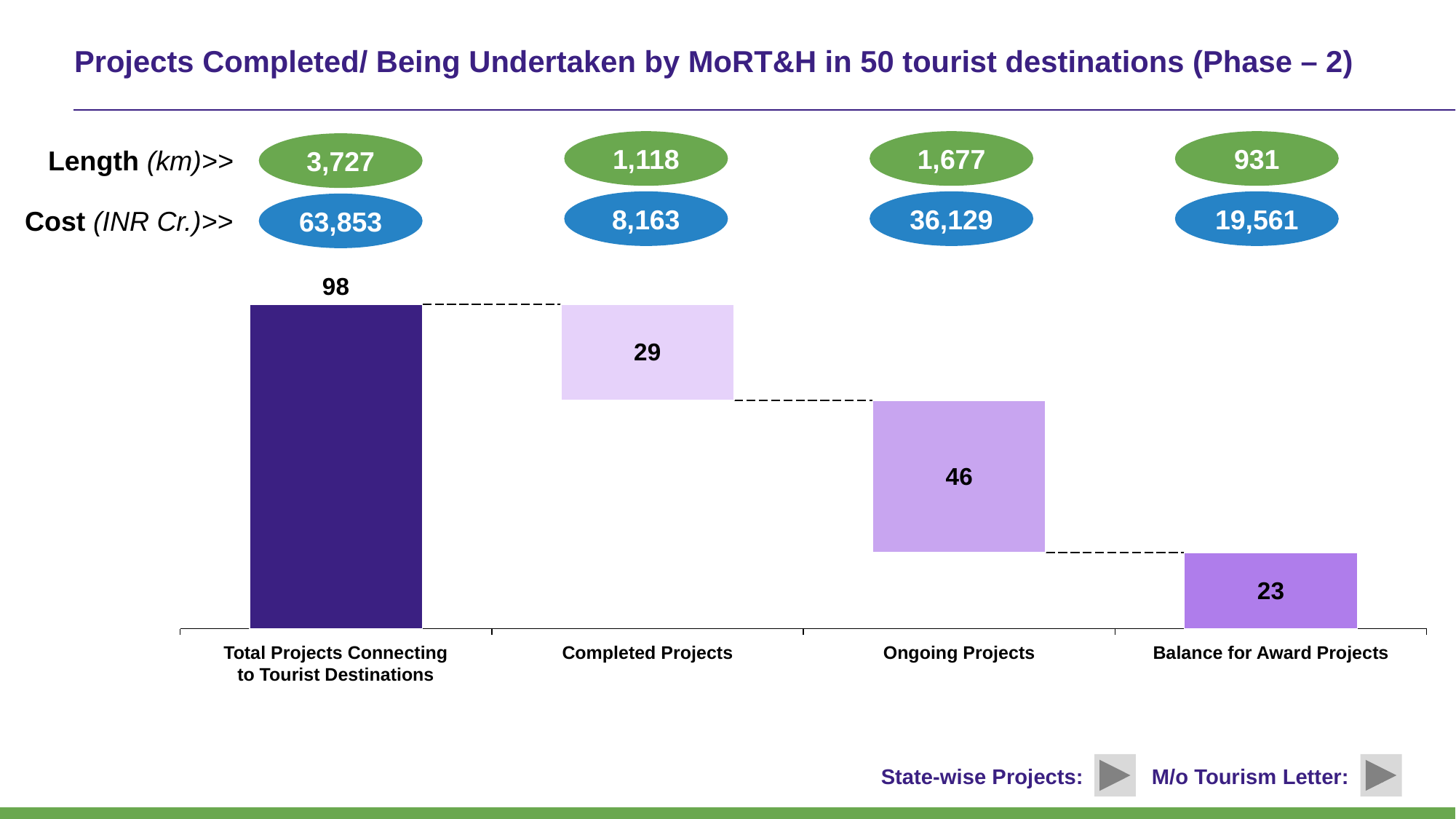
What is the value for Balance for Award Projects? 23 What is the difference between Total Projects Connecting to Tourist Destinations and Ongoing Projects? 52 How many categories are shown on the x axis? 4 What is the value for Completed Projects? 29 What kind of chart is shown on the slide? Bar chart (waterfall) Which is larger, Completed Projects or Balance for Award Projects? Completed Projects What is the value for Ongoing Projects? 46 What is the title of the slide? Projects Completed/ Being Undertaken by MoRT&H in 50 tourist destinations (Phase – 2) What is the value for Total Projects Connecting to Tourist Destinations? 98 Which category has the highest value? Total Projects Connecting to Tourist Destinations What is the difference between Ongoing Projects and Completed Projects? 17 Which category has the lowest value? Balance for Award Projects